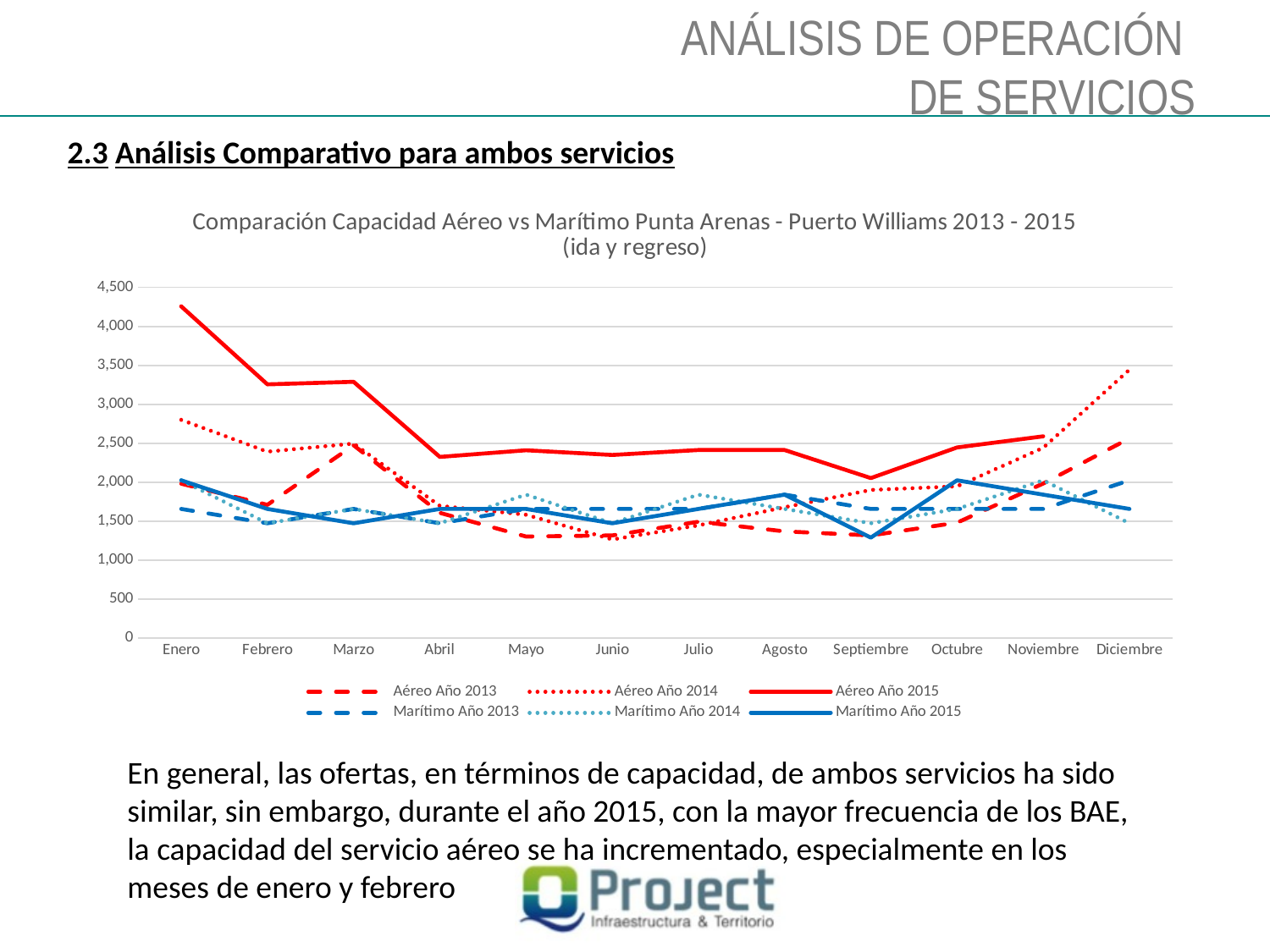
In which month does the Aéreo Año 2015 series reach its lowest value? Septiembre In Enero, which is larger: Aéreo Año 2015 or Marítimo Año 2015? Aéreo Año 2015 Is the value for Aéreo Año 2015 in Enero greater or less than 4,000? greater Is the value for Aéreo Año 2014 in Diciembre greater or less than 3,000? greater How many months are shown along the x axis? 12 Is the value for Marítimo Año 2015 in Septiembre greater or less than 1,500? less Does the Aéreo Año 2015 series rise or fall from Enero to Abril? Fall In which month does the Aéreo Año 2015 series reach its highest value? Enero What kind of chart is shown on the slide? Line chart What is the title of the chart? Comparación Capacidad Aéreo vs Marítimo Punta Arenas - Puerto Williams 2013 - 2015 (ida y regreso) How many series does the legend list? 6